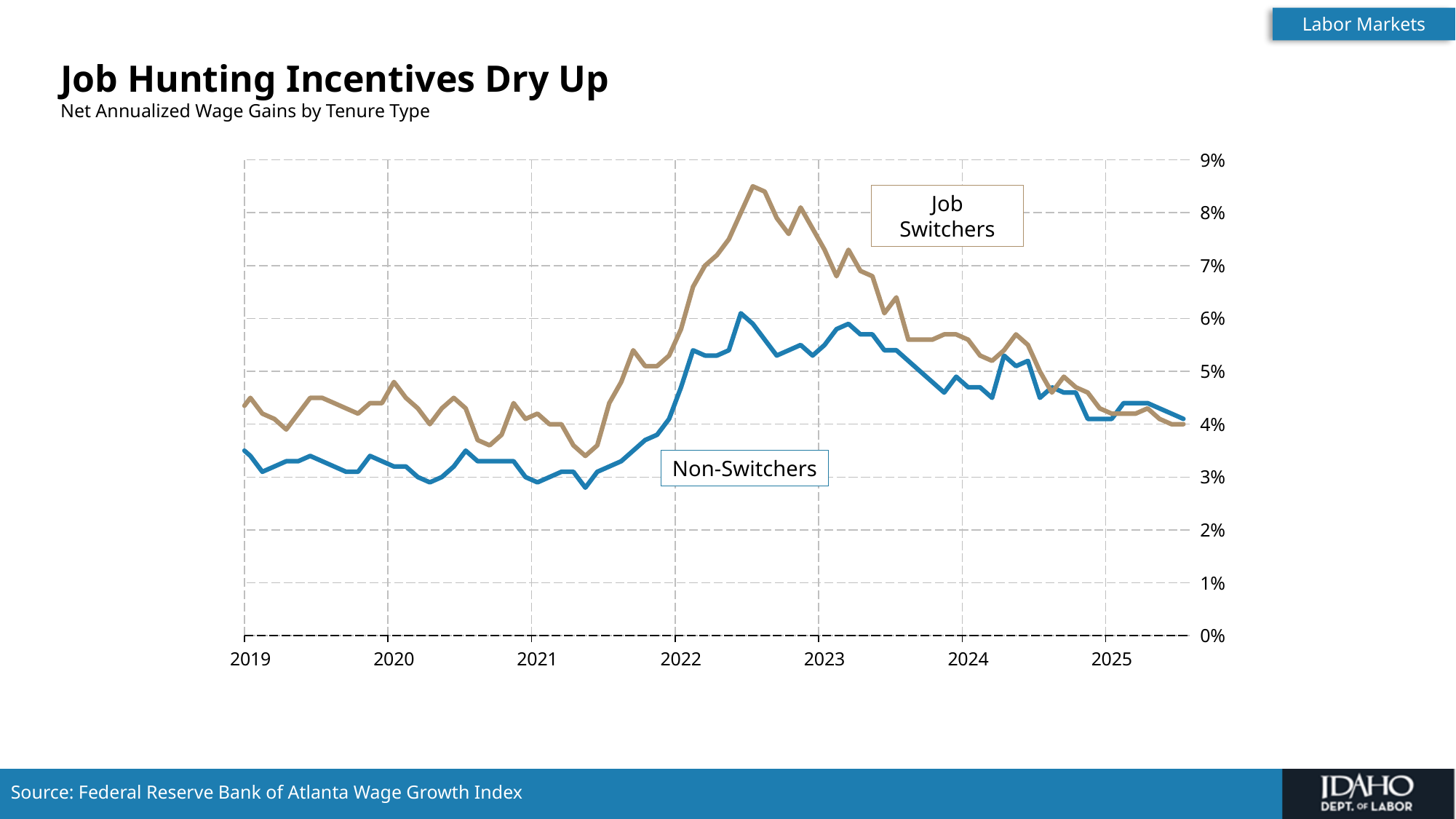
Do the Job Switchers values rise or fall from mid-2022 to 2025? fall How many data series are plotted on the chart? 2 What kind of chart is shown on the slide? line chart Is the peak value for Job Switchers in 2022 greater or less than 8%? greater Is the value for Non-Switchers at the start of 2019 greater or less than 4%? less Is the value for Job Switchers at the start of 2019 greater or less than 4%? greater Which series reaches the higher peak value, Job Switchers or Non-Switchers? Job Switchers What is the source cited for the chart? Federal Reserve Bank of Atlanta Wage Growth Index What is the title of the chart on the slide? Job Hunting Incentives Dry Up Do the Non-Switchers values rise or fall from mid-2021 to early 2022? rise